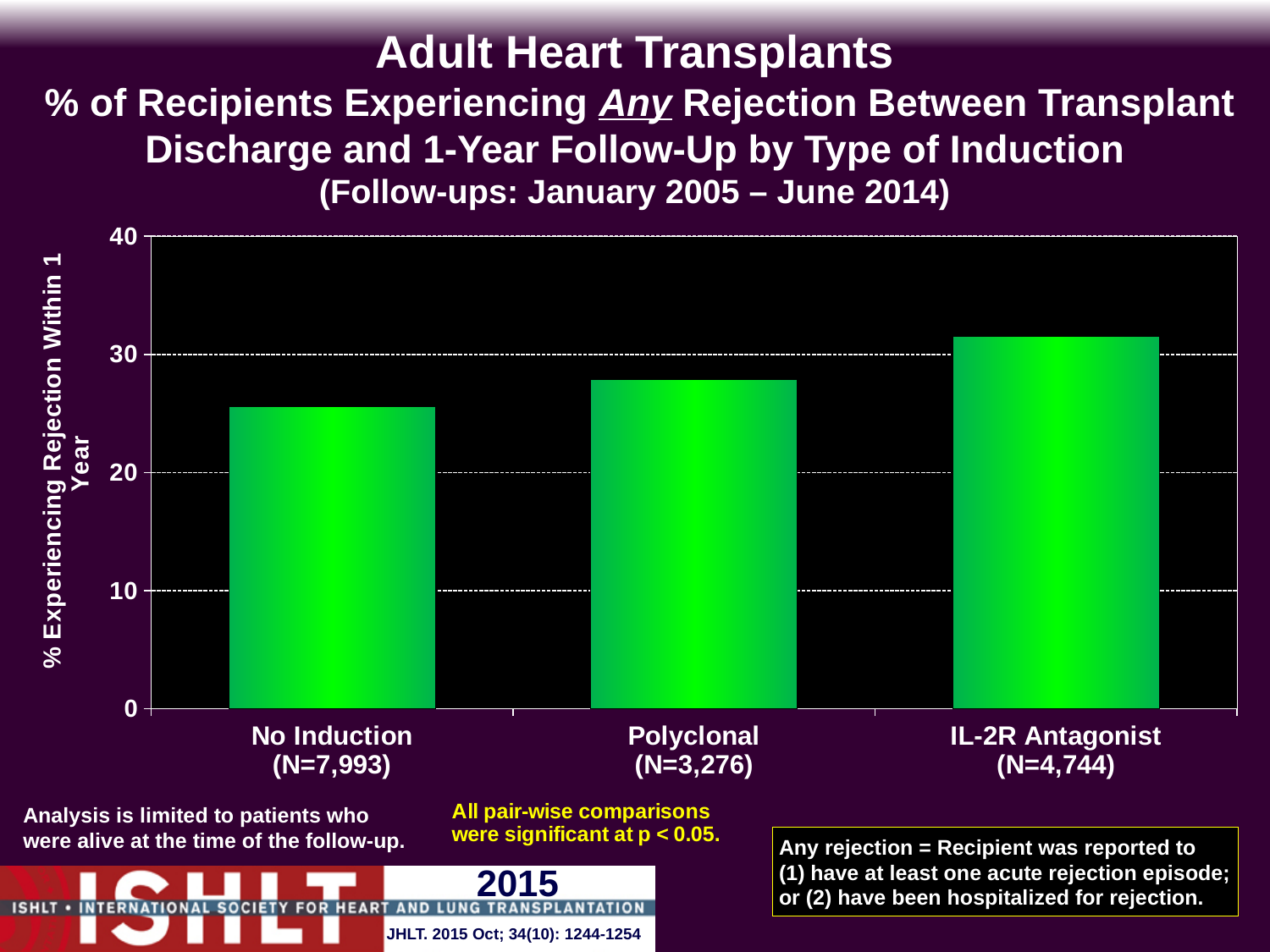
Is the value for Polyclonal greater or less than 30? less Is the value for IL-2R Antagonist greater or less than 30? greater What follow-up period is given in the chart title? January 2005 – June 2014 How many induction-type categories are plotted on the chart? 3 Which has a higher percentage of recipients experiencing rejection: Polyclonal or No Induction? Polyclonal Which induction type has the highest percentage of recipients experiencing rejection within 1 year? IL-2R Antagonist What kind of chart is shown on the slide? bar chart Which induction type has the lowest percentage of recipients experiencing rejection within 1 year? No Induction Which has a higher percentage of recipients experiencing rejection: IL-2R Antagonist or Polyclonal? IL-2R Antagonist What is the N shown for the Polyclonal category? N=3,276 Do the bar values rise or fall moving from No Induction to IL-2R Antagonist along the x axis? rise Is the value for No Induction greater or less than 20? greater